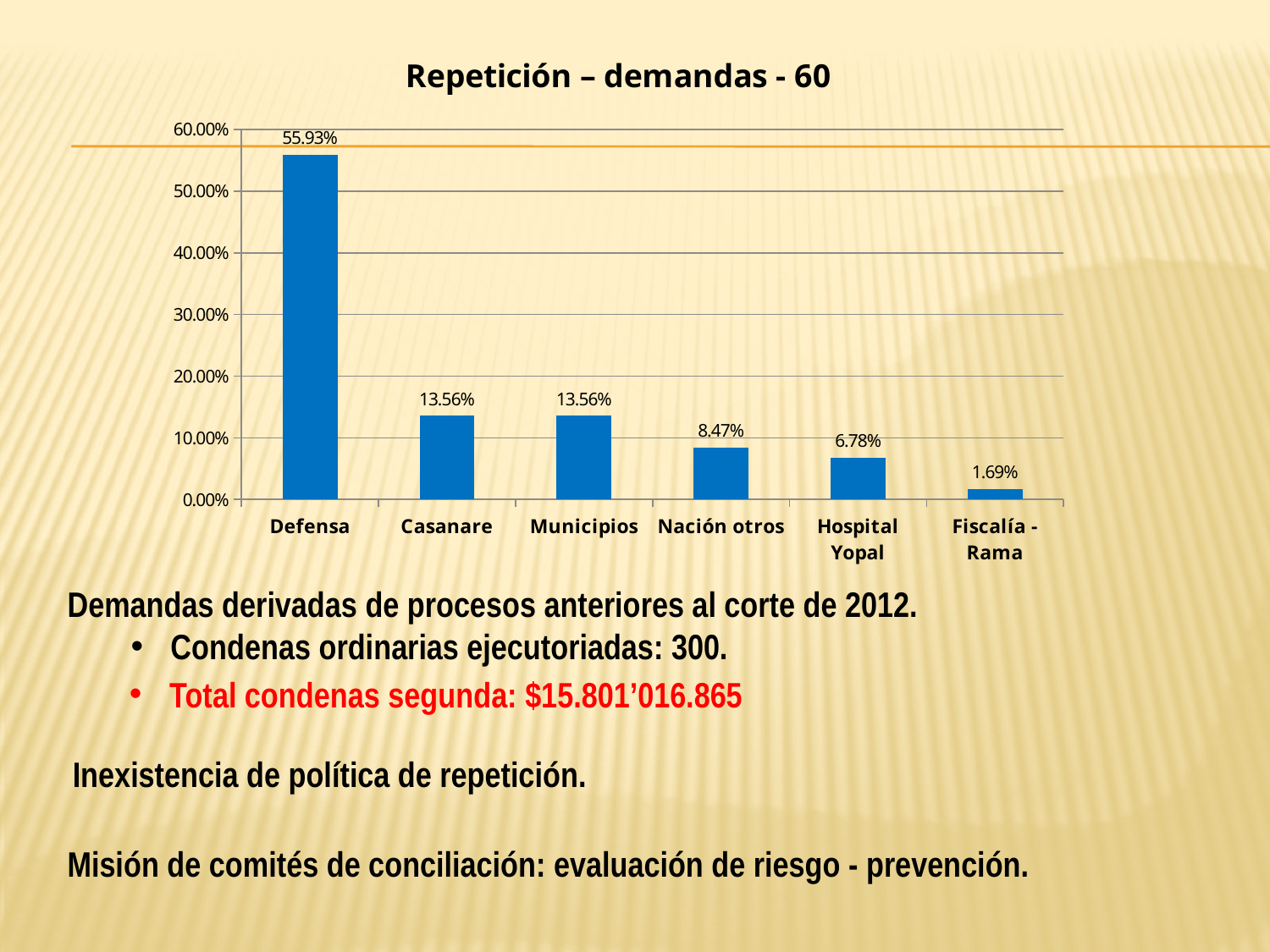
Which category has the highest value? Defensa What is the difference between the values for Defensa and Casanare? 42.37% What is the value for Fiscalía - Rama? 1.69% What is the value for Nación otros? 8.47% Which category has the lowest value? Fiscalía - Rama What is the value for Defensa? 55.93% How many categories are shown on the x axis? 6 What is the value for Hospital Yopal? 6.78% Is the value for Defensa greater or less than 50.00%? greater Which is larger, the value for Nación otros or the value for Hospital Yopal? Nación otros What is the title of the chart? Repetición – demandas - 60 What kind of chart is shown on the slide? Bar chart